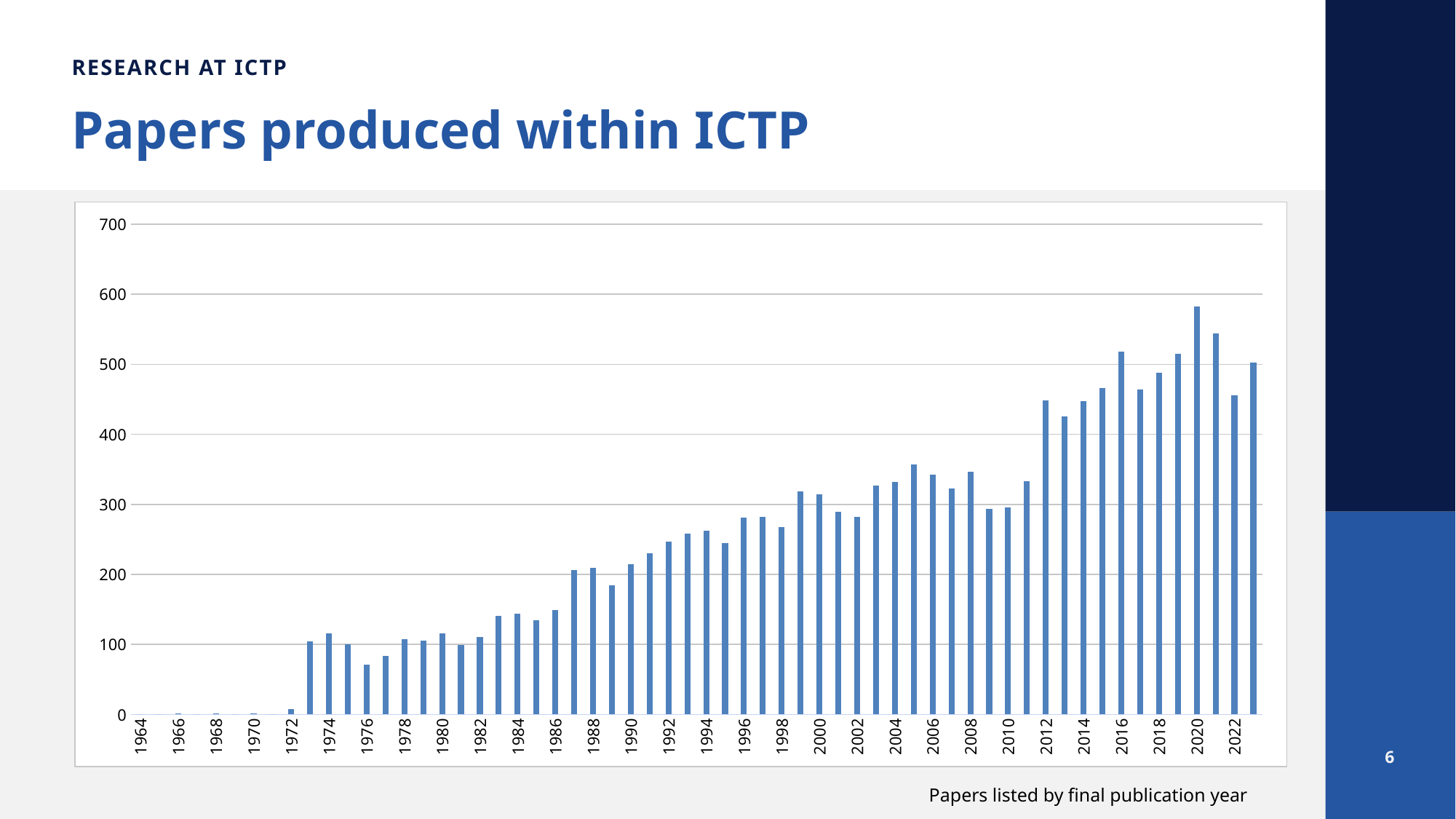
What is the title of the slide containing the chart? Papers produced within ICTP Which year has the highest number of papers? 2020 Is the value for 2022 greater or less than 500? less Which year has the larger value, 2012 or 2013? 2012 What kind of chart is shown on the slide? bar chart Is the value for 1989 greater or less than 200? less Is the value for 2012 greater or less than 400? greater Overall, do the values rise or fall from 1964 to 2023? rise Which year has the larger value, 2020 or 2021? 2020